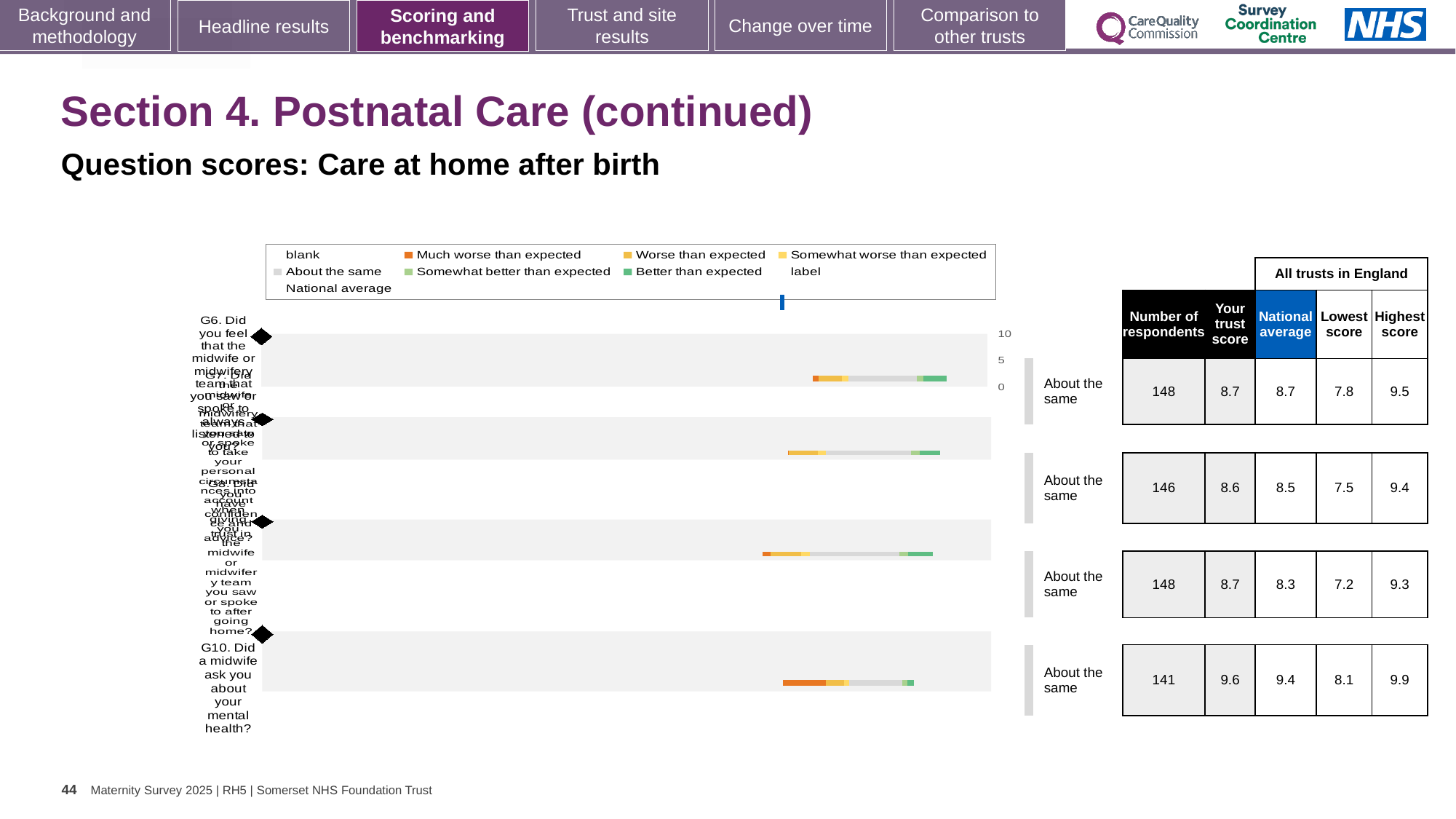
In the table beside the chart, what is the trust score for G10 (Did a midwife ask you about your mental health?)? 9.6 Which legend entry is shown in orange? Much worse than expected In the table beside the chart, what is the number of respondents for G10 (Did a midwife ask you about your mental health?)? 141 In the table beside the chart, what is the difference between the highest score and the lowest score for G10 (Did a midwife ask you about your mental health?)? 1.8 In the table beside the chart, is the trust score for G10 (Did a midwife ask you about your mental health?) larger or smaller than the national average? larger How many question bars are plotted in the chart? 4 What kind of chart is shown on the slide? bar chart In the table beside the chart, what is the national average for G10 (Did a midwife ask you about your mental health?)? 9.4 What benchmark category is shown next to the bar for G10 (Did a midwife ask you about your mental health?)? About the same What is the highest value shown on the chart's axis? 10